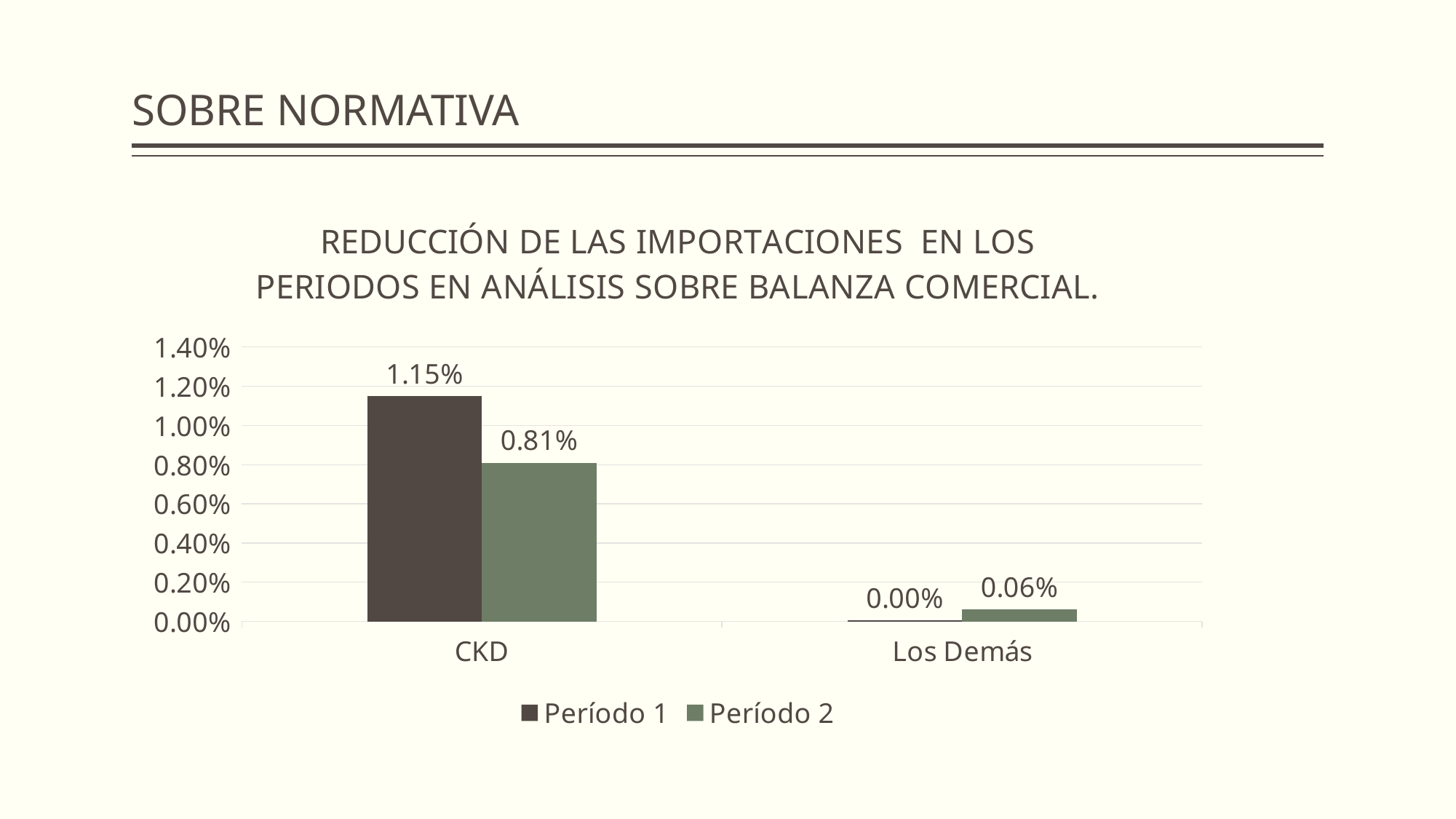
Which category has the lowest value in Período 2? Los Demás Which category has the highest value in Período 1? CKD Which is larger for CKD: the Período 1 value or the Período 2 value? Período 1 What is the value for CKD in Período 2? 0.81% What is the value for Los Demás in Período 1? 0.00% What kind of chart is shown on the slide? Bar chart What is the value for CKD in Período 1? 1.15% Is the Período 1 value for CKD greater or less than 1.00%? greater How many categories are shown on the x axis? 2 How many series does the legend list? 2 What is the difference between the Período 1 and Período 2 values for CKD? 0.34% What is the value for Los Demás in Período 2? 0.06%